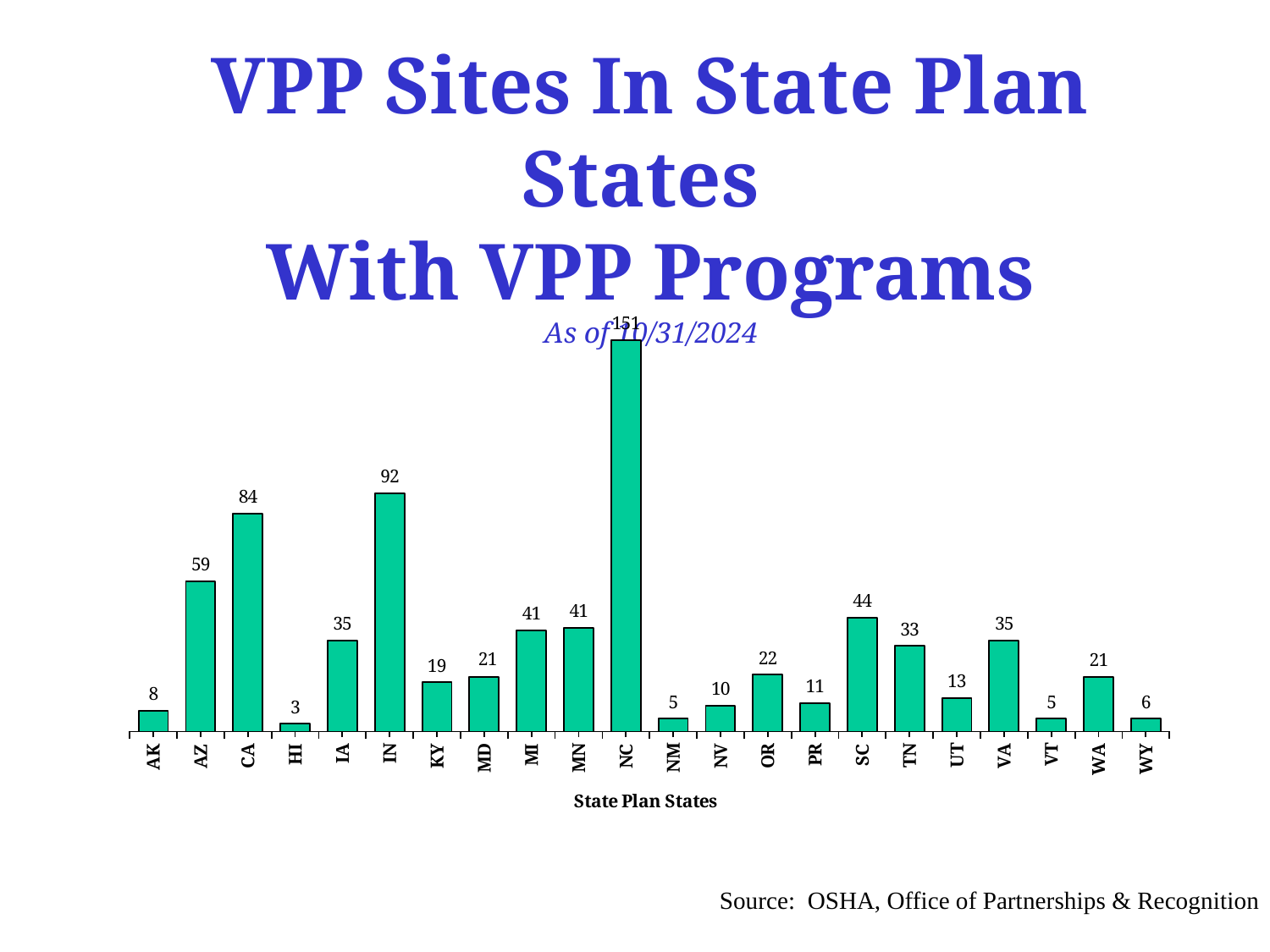
How many VPP sites does California (CA) have? 84 What is the difference between the values for CA and AZ? 25 Which state has the lowest number of VPP sites? HI Which has more VPP sites, SC or TN? SC What is the value shown for Virginia (VA)? 35 What is the value shown for Indiana (IN)? 92 What type of chart is shown on the slide? bar chart What is the difference between the values for IN and IA? 57 What is the value shown for Hawaii (HI)? 3 What is the x-axis title of the chart? State Plan States Which state has the highest number of VPP sites? NC How many states are shown on the x axis? 22